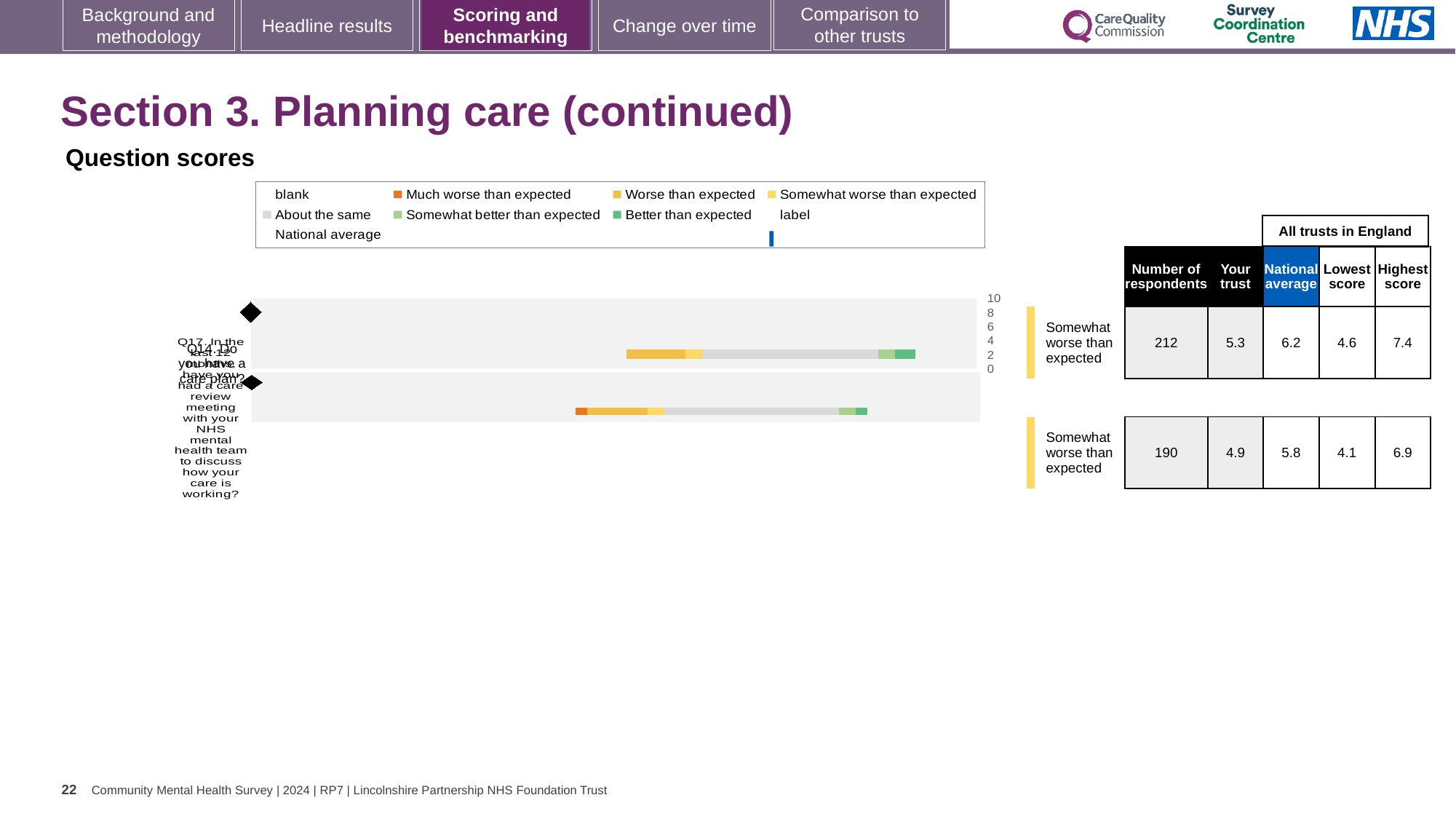
In the first row of the table, how much higher is the national average than the 'Your trust' score? 0.9 What colour does the legend use for 'Much worse than expected'? orange In the table beside the chart, what is the national average in the first row? 6.2 What kind of chart is shown under 'Question scores'? bar chart In the table beside the chart, what is the number of respondents in the first row? 212 In the table beside the chart, what is the 'Your trust' score in the second row? 4.9 Which row of the table has more respondents, the first or the second? the first In the table beside the chart, what is the lowest score in the first row? 4.6 In the second row of the table, which is larger: the 'Your trust' score or the national average? national average In the table beside the chart, what is the highest score in the second row? 6.9 What benchmark rating is shown next to both bars in the chart? Somewhat worse than expected How many bars are plotted in the chart? 2